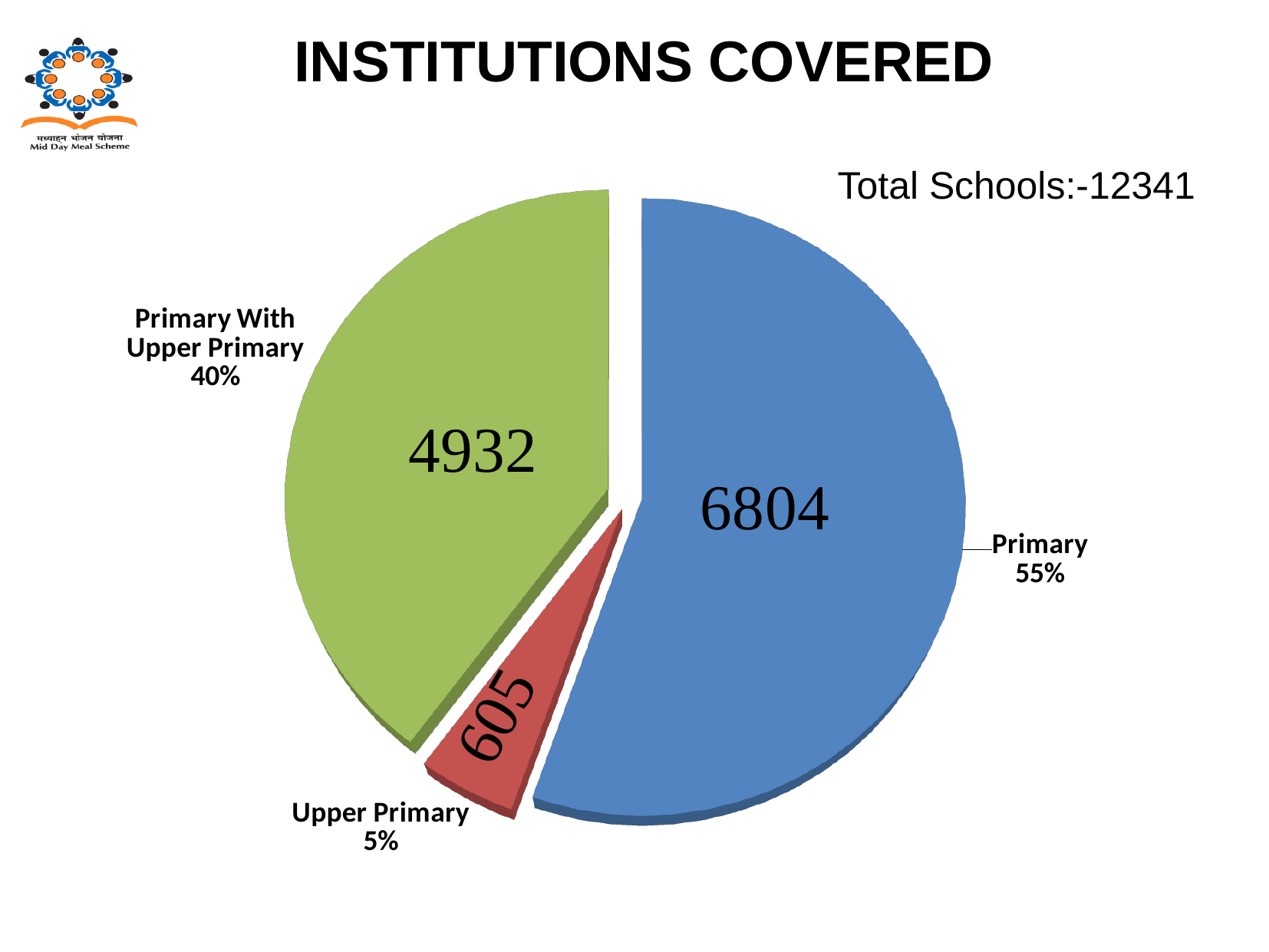
How many categories does the pie chart show? 3 What is the total number of schools stated on the slide? 12341 How many institutions are in the Primary With Upper Primary category? 4932 Which category has the largest slice of the pie? Primary How many institutions are in the Upper Primary category? 605 How many institutions are in the Primary category? 6804 What share of the pie does the Primary With Upper Primary slice represent? 40% What share of the pie does the Upper Primary slice represent? 5% Which category has the smallest slice of the pie? Upper Primary What share of the pie does the Primary slice represent? 55% What kind of chart is shown on the slide? Pie chart What is the difference between the Primary and Primary With Upper Primary values? 1872